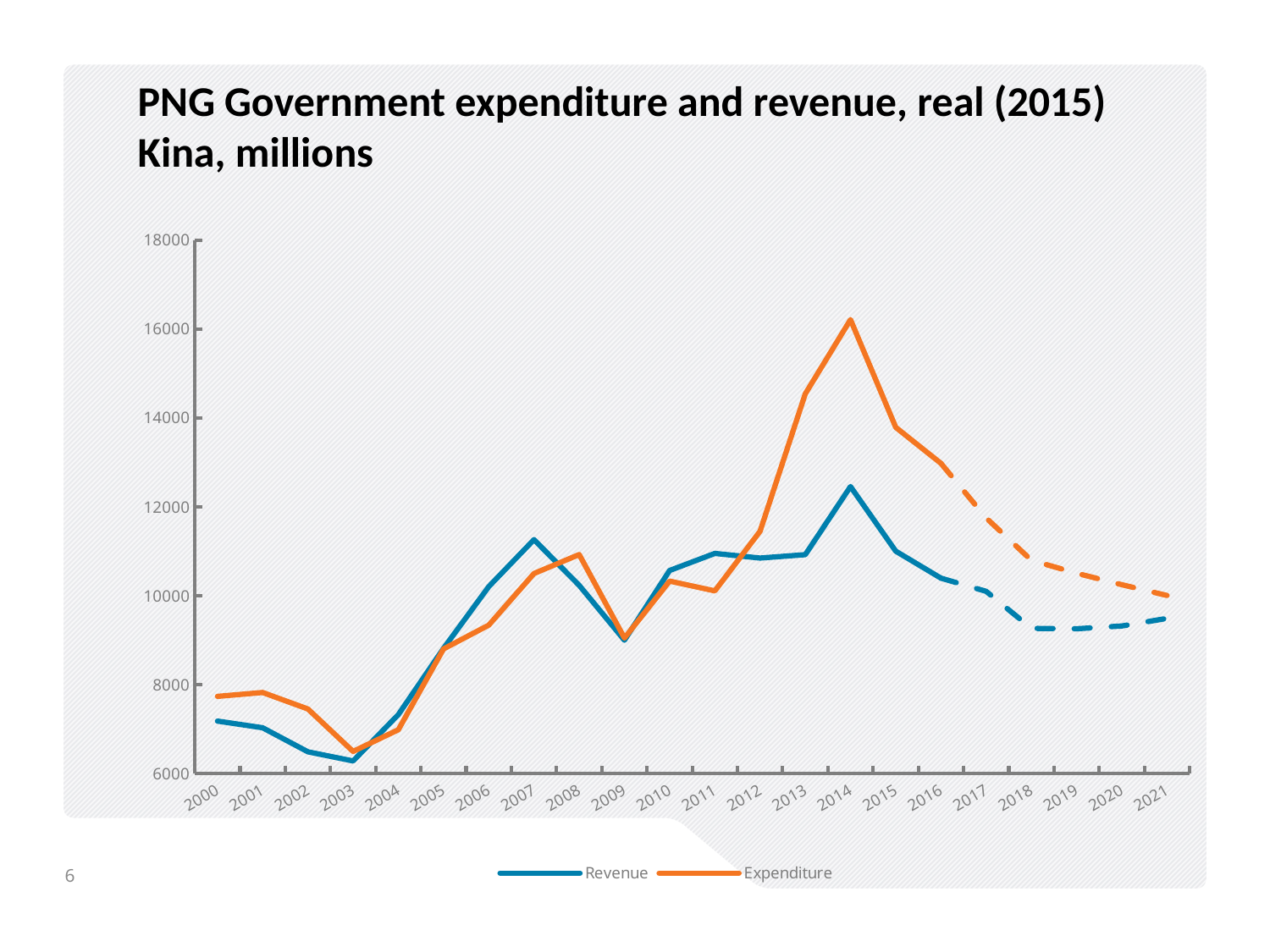
In 2014, which is larger, Revenue or Expenditure? Expenditure What is the title of the chart? PNG Government expenditure and revenue, real (2015) Kina, millions What kind of chart is shown on the slide? Line chart In which year is Revenue at its lowest? 2003 Is the value for Expenditure in 2014 greater or less than 14000? greater In 2007, which is larger, Revenue or Expenditure? Revenue How many series does the legend list? 2 Does Revenue rise or fall from 2014 to 2018? Fall In which year does Expenditure reach its highest value? 2014 Is the value for Revenue in 2003 greater or less than 8000? less Is the value for Revenue in 2021 greater or less than 10000? less How many years are shown on the x axis? 22